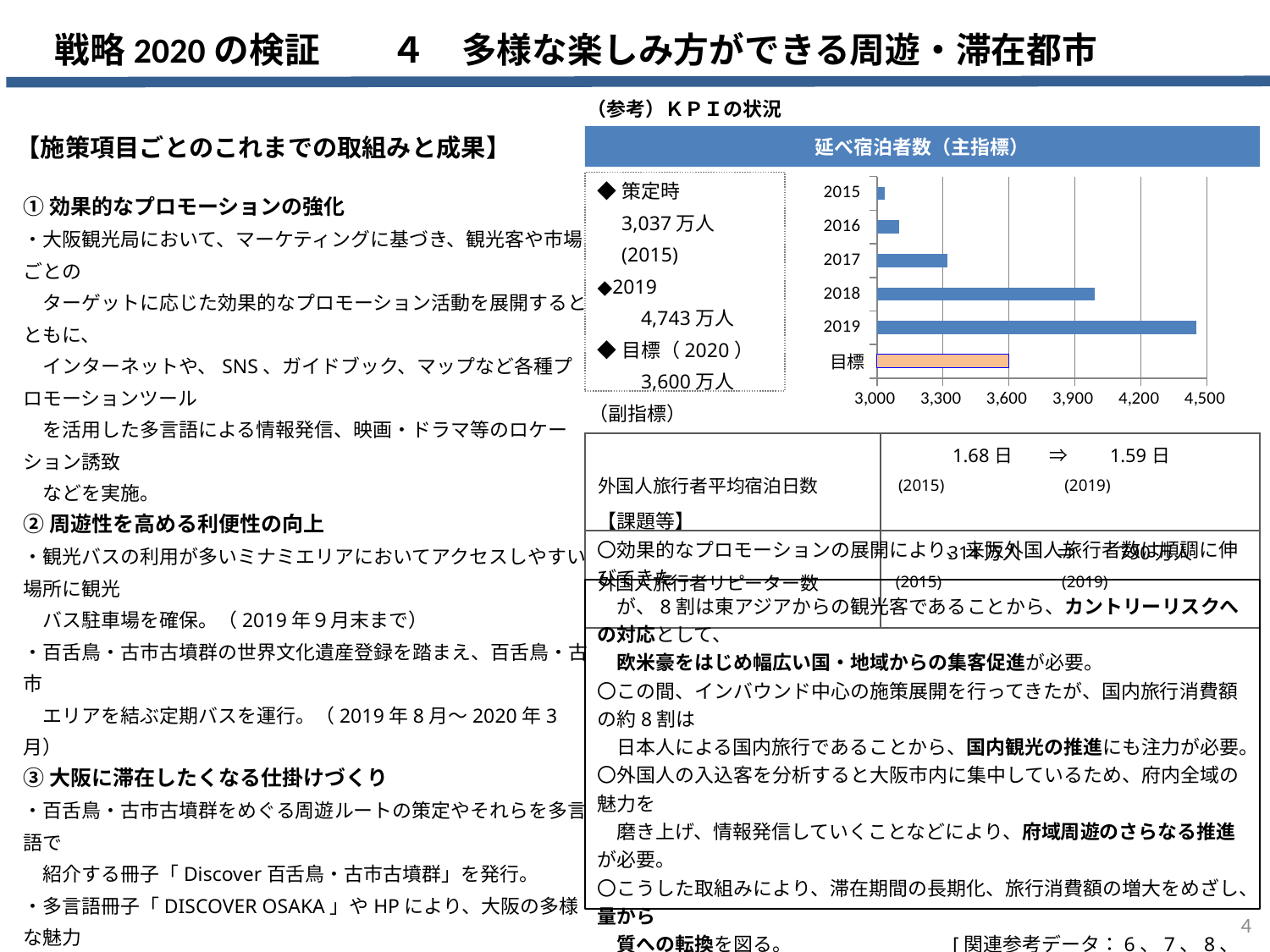
In the 延べ宿泊者数（主指標） chart, is the value for 2016 greater or less than 3,300? less In the 延べ宿泊者数（主指標） chart, which bar is drawn in a different colour (orange) from the others? 目標 In the 延べ宿泊者数（主指標） chart, which category has the shortest bar? 2015 In the 延べ宿泊者数（主指標） chart, is the bar for 2018 longer or shorter than the bar for 目標? longer In the 延べ宿泊者数（主指標） chart, which category has the longest bar? 2019 What kind of chart is shown under 延べ宿泊者数（主指標）? bar chart How many bars are plotted in the 延べ宿泊者数（主指標） chart? 6 In the 延べ宿泊者数（主指標） chart, do the values rise or fall from 2015 to 2019? rise In the 延べ宿泊者数（主指標） chart, is the value for 2019 greater or less than 4,200? greater According to the 延べ宿泊者数（主指標） chart and its side note, what is the 目標（2020） value? 3,600万人 In the 延べ宿泊者数（主指標） chart, is the value for 2017 greater or less than 3,600? less